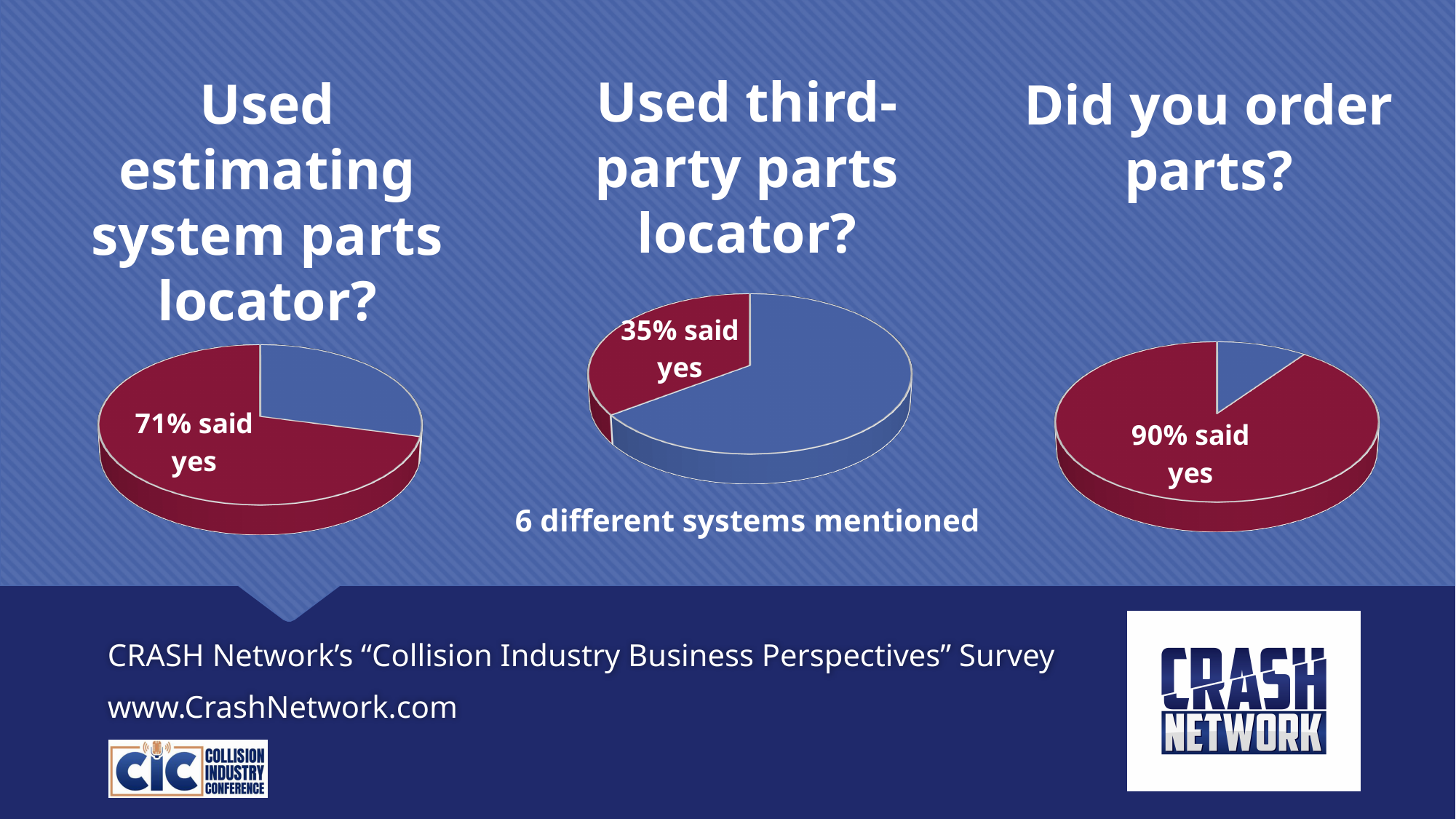
Which of the three charts shows the lowest percentage saying yes? Used third-party parts locator? What kind of chart is used for the 'Did you order parts?' question? Pie chart In the 'Used estimating system parts locator?' chart, what percentage said yes? 71% How many pie charts are shown on the slide? 3 According to the text under the 'Used third-party parts locator?' chart, how many different systems were mentioned? 6 In the 'Used third-party parts locator?' chart, what percentage said yes? 35% What is the difference between the yes percentage in the 'Did you order parts?' chart and the yes percentage in the 'Used estimating system parts locator?' chart? 19% Which of the three charts shows the highest percentage saying yes? Did you order parts? In the 'Did you order parts?' chart, what percentage said yes? 90% What is the difference between the yes percentage in the 'Used estimating system parts locator?' chart and the yes percentage in the 'Used third-party parts locator?' chart? 36% In the 'Used third-party parts locator?' chart, is the 'said yes' slice shown in red or blue? Red Is the yes percentage larger in the 'Used estimating system parts locator?' chart or the 'Used third-party parts locator?' chart? Used estimating system parts locator?